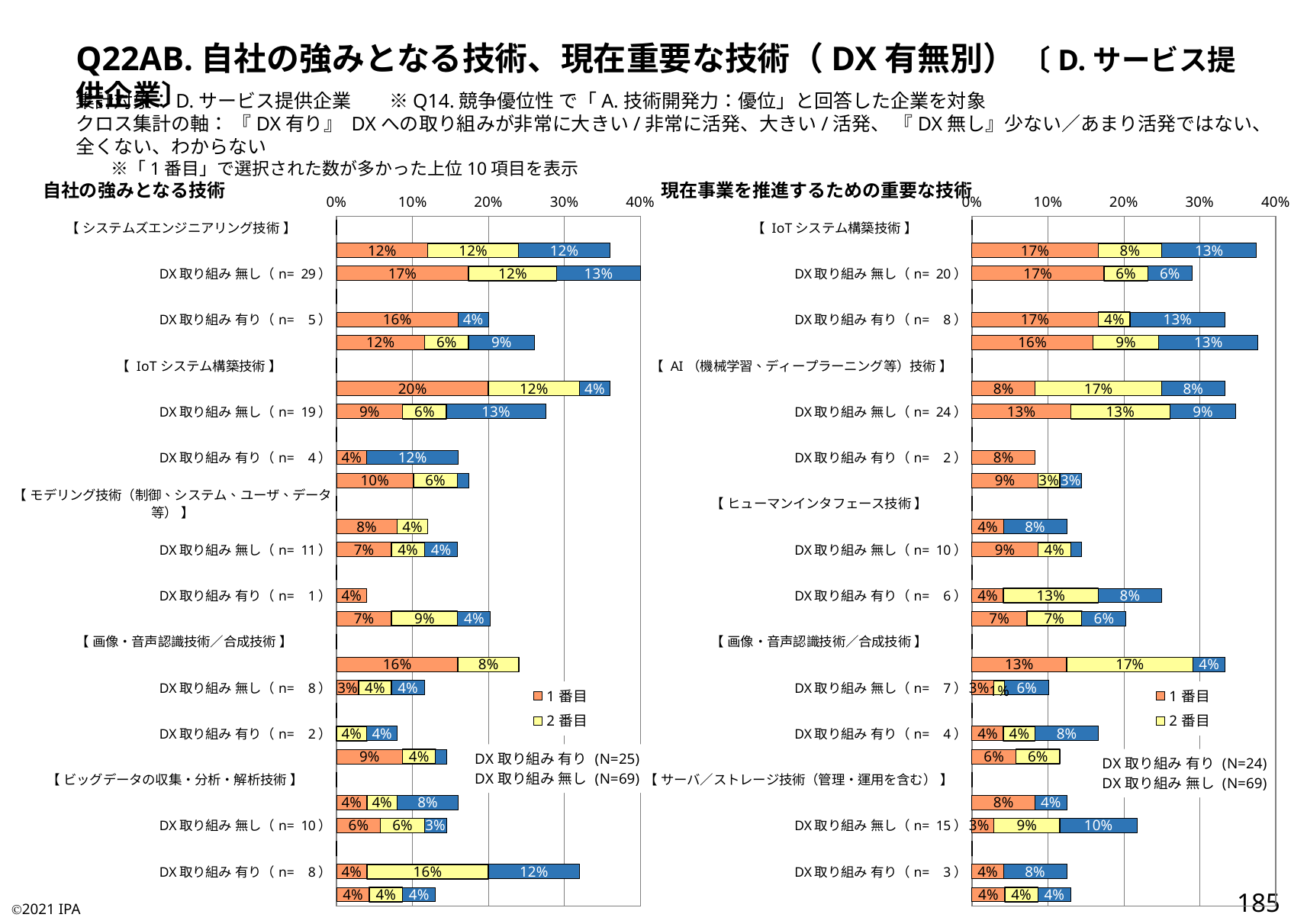
In the right chart (現在事業を推進するための重要な技術), which is larger: the 1番目 value for DX取り組み無し (n=20) or the 1番目 value for DX取り組み無し (n=7)? DX取り組み無し (n=20) In the left chart (自社の強みとなる技術), what is the 1番目 value for the row DX取り組み無し (n=29)? 17% In the right chart (現在事業を推進するための重要な技術), what is the total of the stacked bar for DX取り組み有り (n=8)? 34% In the right chart (現在事業を推進するための重要な技術), what is the 1番目 value for the row DX取り組み無し (n=20)? 17% What is the title of the right chart on the slide? 現在事業を推進するための重要な技術 In the left chart (自社の強みとなる技術), what is the difference between the 1番目 value for DX取り組み無し (n=29) and the 1番目 value for DX取り組み無し (n=19)? 8% How many series does the legend of the right chart (現在事業を推進するための重要な技術) list? 2 In the left chart (自社の強みとなる技術), what is the 2番目 value for the row DX取り組み有り (n=8)? 16% What kind of chart is the left chart titled 自社の強みとなる技術? bar chart In the right chart (現在事業を推進するための重要な技術), what is the 2番目 value for the row DX取り組み無し (n=24)? 13% In the left chart (自社の強みとなる技術), what is the total of the stacked bar for DX取り組み無し (n=29)? 42% In the left chart (自社の強みとなる技術), what is the total of the stacked bar for DX取り組み有り (n=8)? 32%